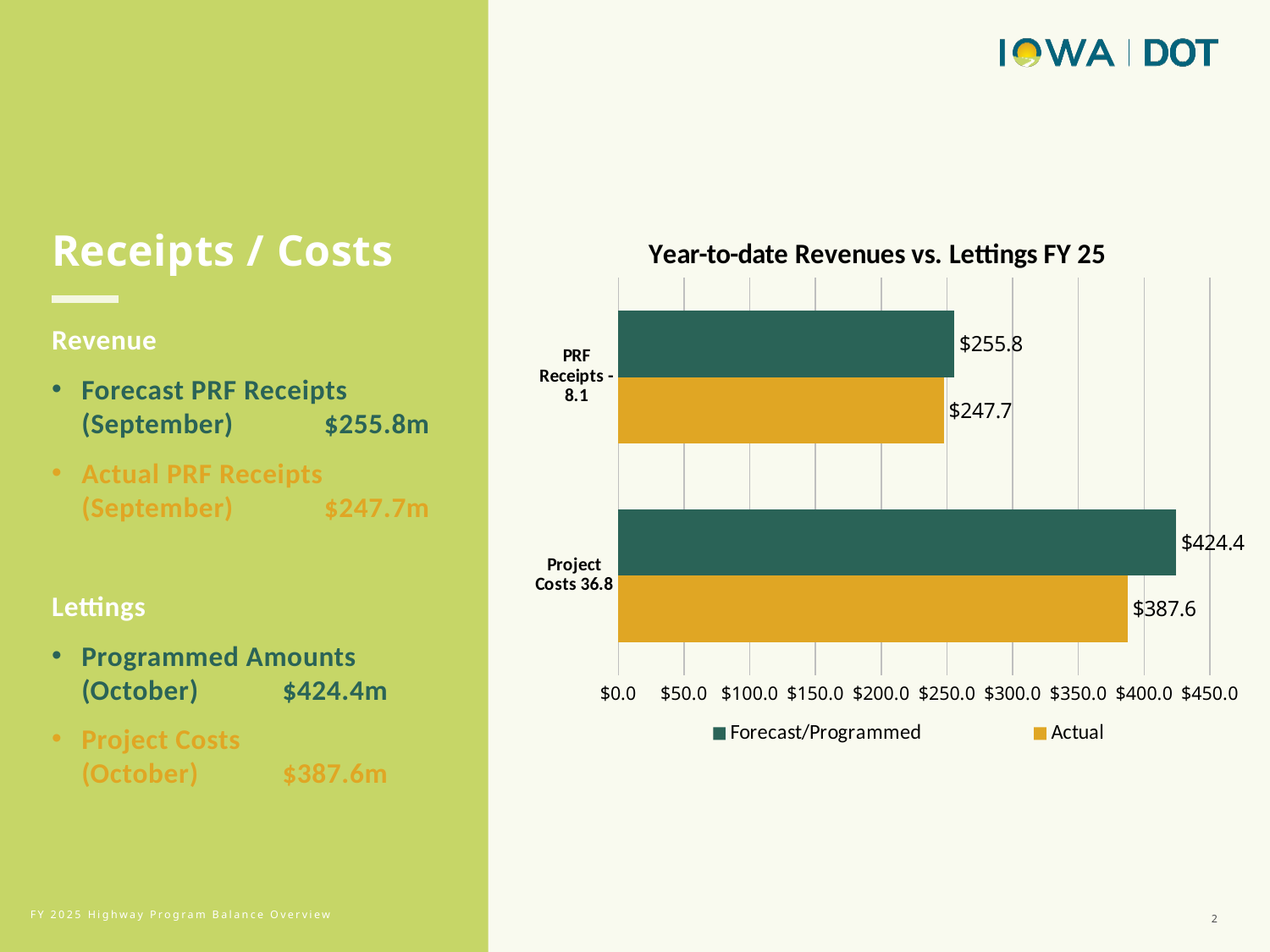
What is the title of the chart? Year-to-date Revenues vs. Lettings FY 25 Which is larger for Project Costs: the Forecast/Programmed value or the Actual value? Forecast/Programmed What is the Forecast/Programmed value for Project Costs? $424.4 What is the Actual value for PRF Receipts? $247.7 What is the difference between the Forecast/Programmed and Actual values for PRF Receipts? $8.1 How many categories are plotted on the chart? 2 What type of chart is shown on the slide? bar chart What is the difference between the Forecast/Programmed and Actual values for Project Costs? $36.8 What is the Forecast/Programmed value for PRF Receipts? $255.8 What is the Actual value for Project Costs? $387.6 How many series does the chart legend list? 2 Which series is shown in orange in the chart legend? Actual